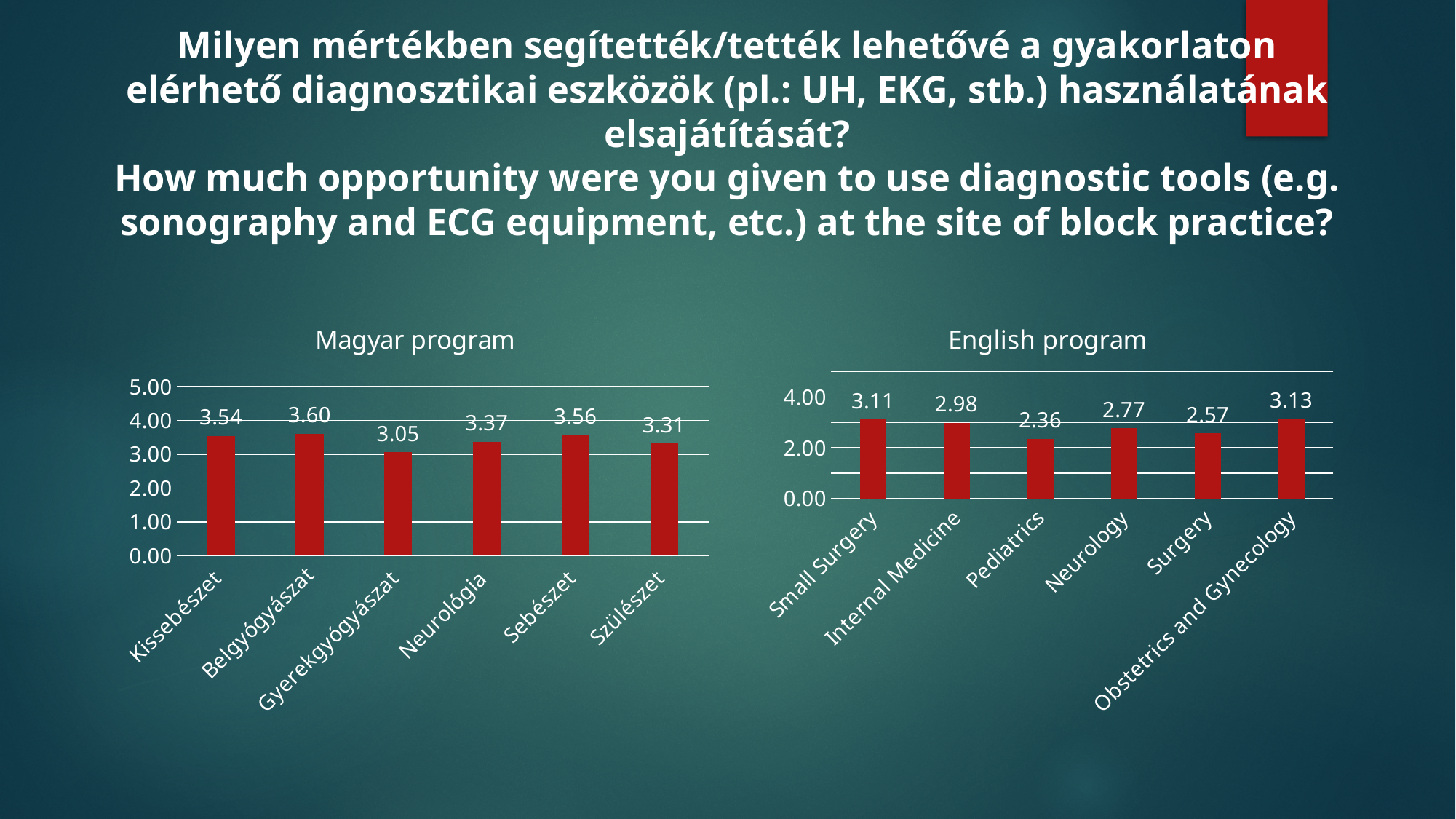
How many categories are shown in the Magyar program chart? 6 In the Magyar program chart, what is the value for Neurológia? 3.37 In the English program chart, what is the value for Pediatrics? 2.36 In the Magyar program chart, what is the difference between the values for Sebészet and Szülészet? 0.25 In the English program chart, which category has the lowest value? Pediatrics In the English program chart, which category has the highest value? Obstetrics and Gynecology In the English program chart, what is the difference between the values for Internal Medicine and Surgery? 0.41 In the English program chart, is the value for Small Surgery greater or less than 2.00? greater In the Magyar program chart, which category has the highest value? Belgyógyászat In the Magyar program chart, which category has the lowest value? Gyerekgyógyászat In the English program chart, which is larger, the value for Neurology or the value for Surgery? Neurology What kind of chart is the English program chart? Bar chart